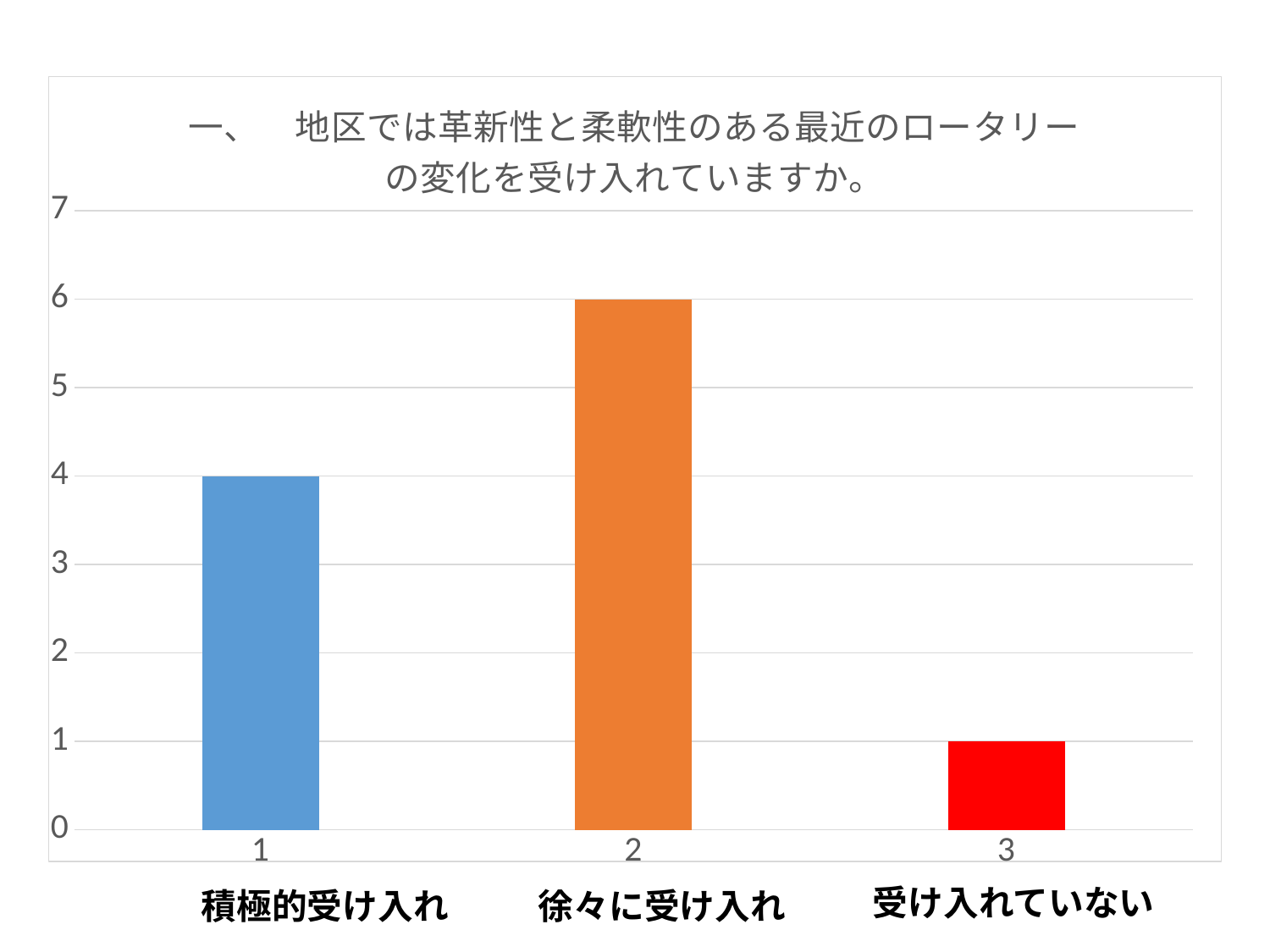
Which is larger, the value for category 1 or the value for category 3? category 1 How many bars (categories) are plotted in the chart? 3 What type of chart is shown on the slide? bar chart What is the value of the bar for category 1 (積極的受け入れ)? 4 What colour is the bar for category 3 (受け入れていない)? red Which category has the lowest bar? 3 (受け入れていない) What is the value of the bar for category 3 (受け入れていない)? 1 What is the difference between the values for category 2 and category 1? 2 Which category has the highest bar? 2 (徐々に受け入れ) What is the value of the bar for category 2 (徐々に受け入れ)? 6 What is the difference between the values for category 1 and category 3? 3 Is the value for category 2 greater or less than 5? greater